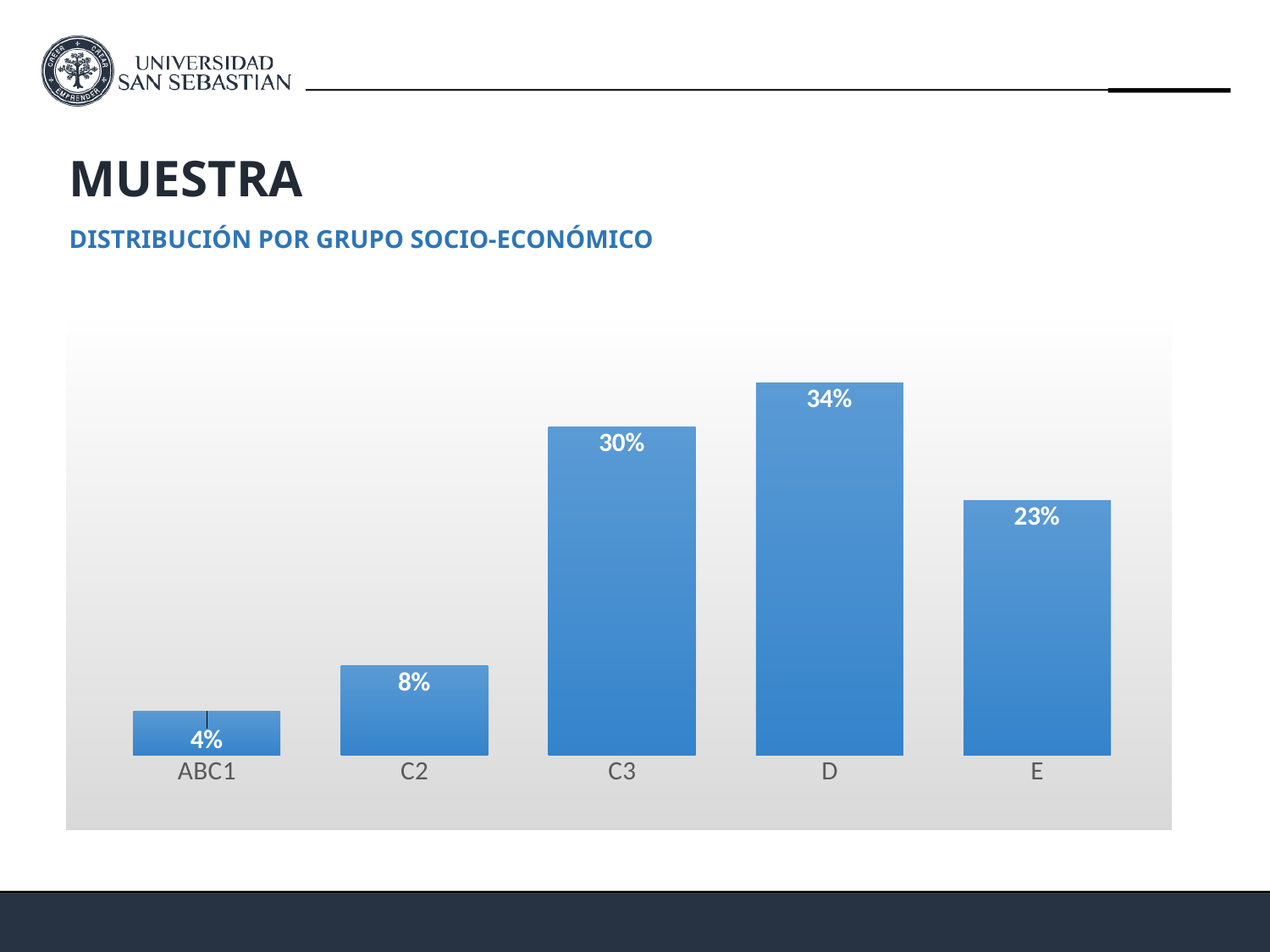
What kind of chart is shown on the slide? Bar chart What is the difference between the values for D and C3? 4% Which is larger, the value for C2 or the value for E? E What colour are the bars in the chart? Blue What is the subtitle describing the chart? DISTRIBUCIÓN POR GRUPO SOCIO-ECONÓMICO What is the value for ABC1? 4% Which group has the highest value? D What is the difference between the values for E and C2? 15% What is the value for C3? 30% Which group has the lowest value? ABC1 How many groups are shown on the x axis? 5 What is the value for E? 23%